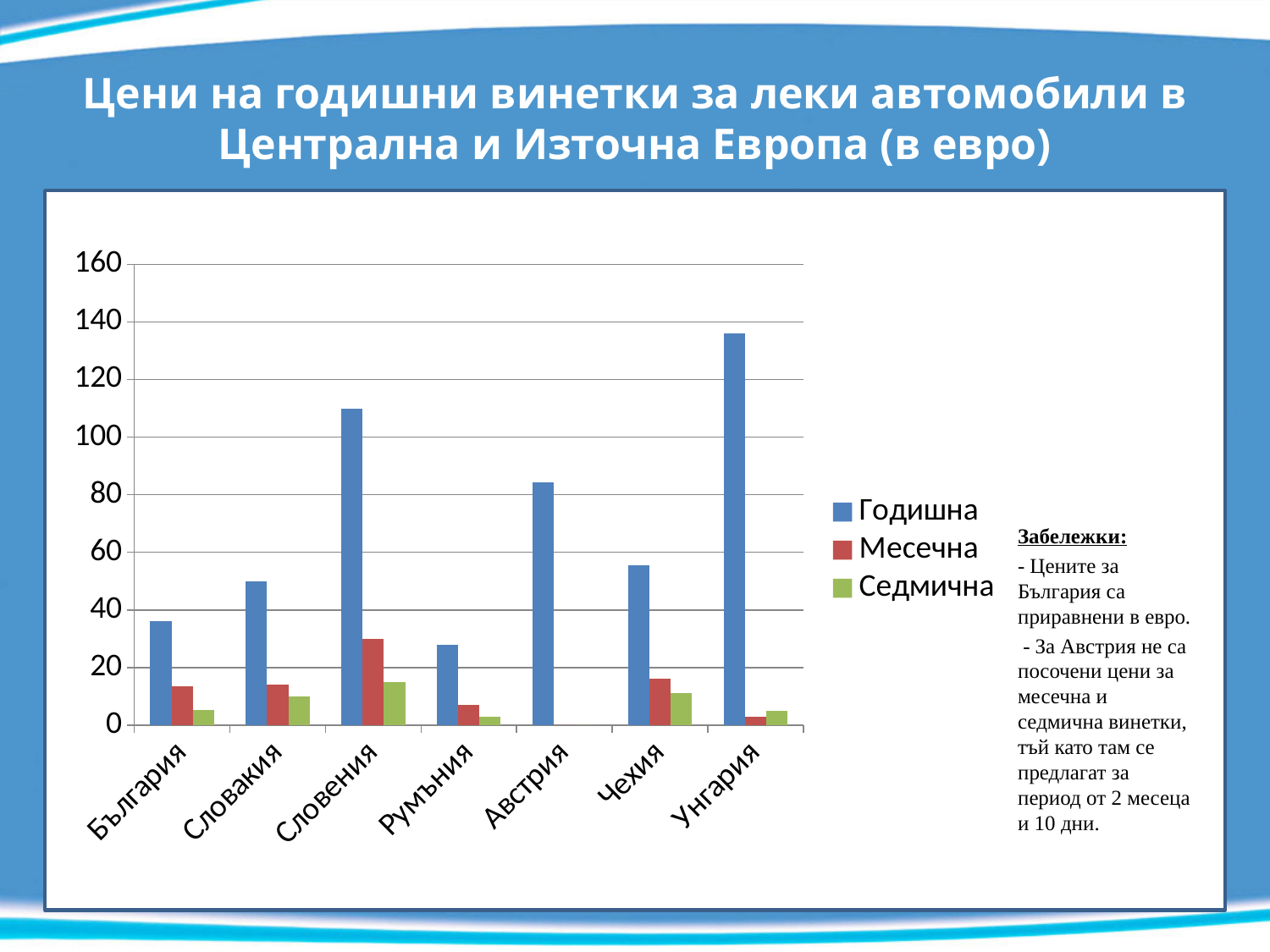
Which country has the highest value for Годишна? Унгария Which country has the lowest value for Годишна? Румъния Is the Годишна value for Унгария greater or less than 120? greater How many countries are shown on the x axis of the chart? 7 Which country has the highest value for Месечна? Словения Is the Годишна value for Румъния greater or less than 40? less Which is larger, the Годишна value for Словения or for Австрия? Словения What kind of chart is shown on the slide? bar chart How many series does the chart legend list? 3 Which series is shown in green in the chart legend? Седмична Is the Месечна value for Словения greater or less than 20? greater